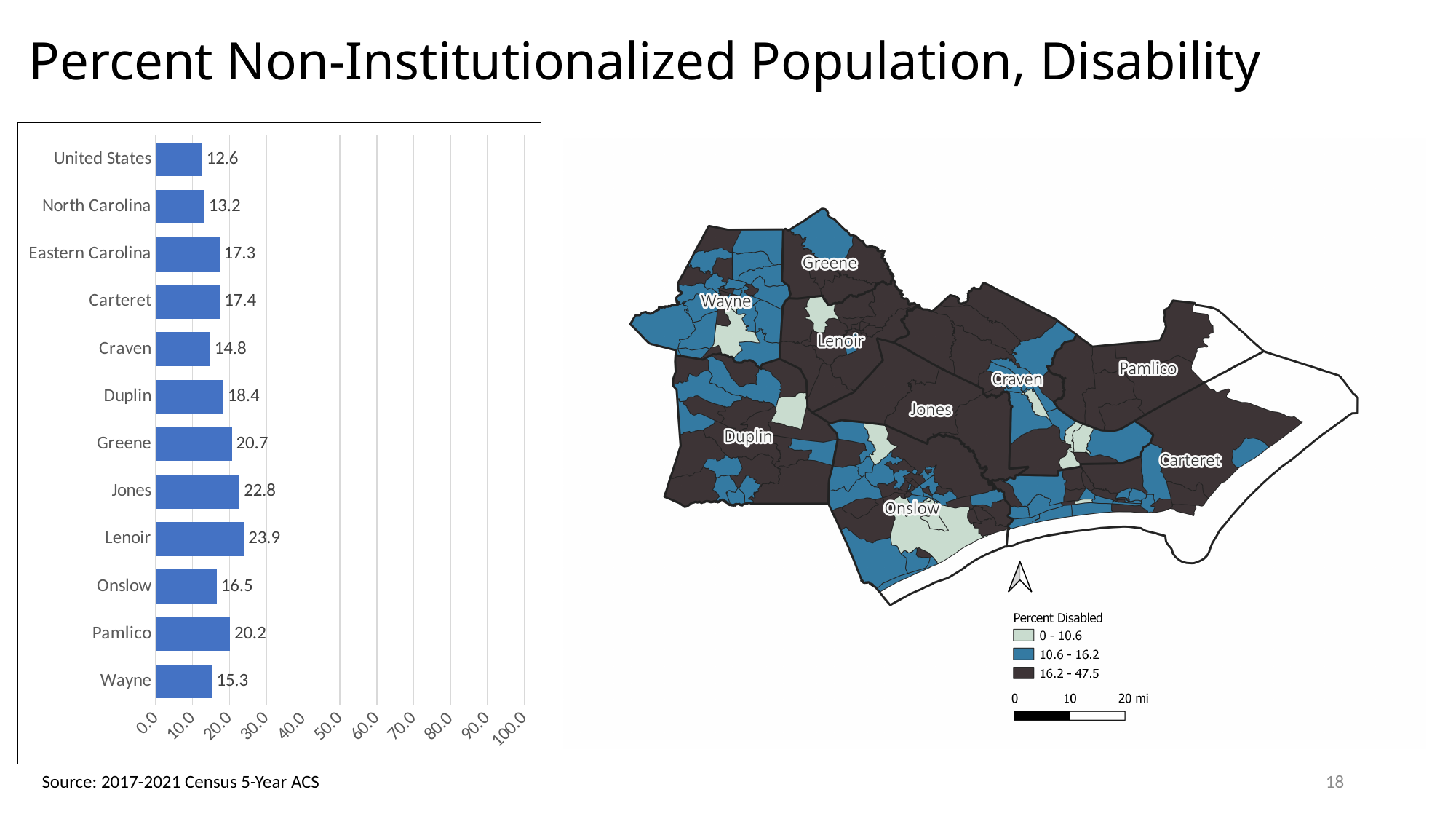
What is the value for the United States in the bar chart? 12.6 What kind of chart is shown on the left of the slide? bar chart How many categories are shown in the bar chart? 12 What is the difference between the values for Jones and Craven in the bar chart? 8.0 Which category has the highest value in the bar chart? Lenoir What is the highest value shown on the x axis of the bar chart? 100.0 Is the value for Duplin in the bar chart greater or less than 20.0? less Which has a larger value in the bar chart, Pamlico or Onslow? Pamlico What is the value for Lenoir in the bar chart? 23.9 Which category has the lowest value in the bar chart? United States What is the value for Greene in the bar chart? 20.7 How many ranges does the map legend 'Percent Disabled' list? 3